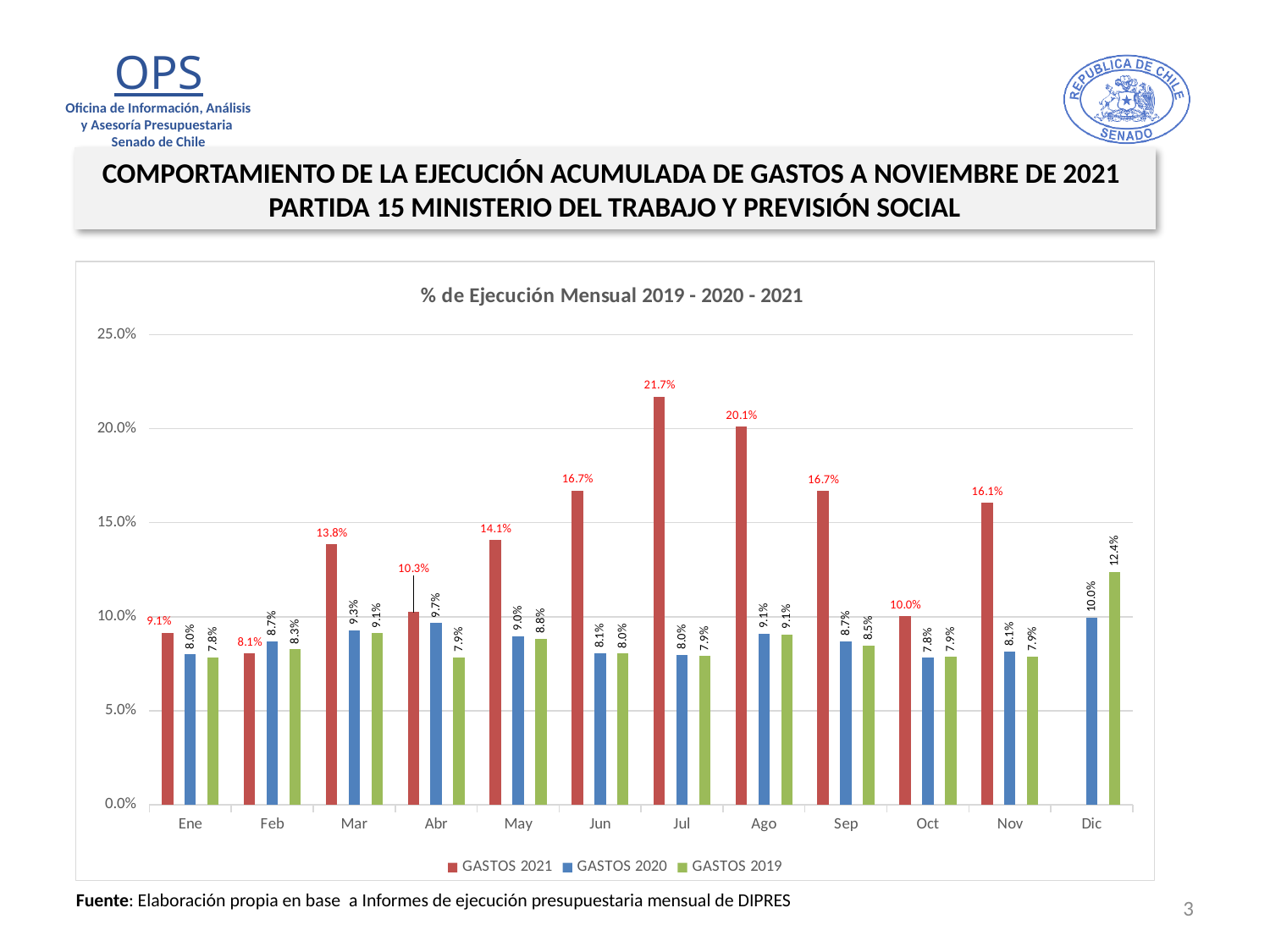
What is the value for GASTOS 2020 in Abr? 9.7% How many months are shown on the x axis? 12 What is the difference between GASTOS 2021 and GASTOS 2020 in Ago? 11.0% Which is larger in Feb: GASTOS 2021 or GASTOS 2020? GASTOS 2020 Is the value for GASTOS 2021 in Mar greater or less than 10.0%? greater What is the title of the chart? % de Ejecución Mensual 2019 - 2020 - 2021 In which month is the GASTOS 2020 value lowest? Oct In which month is the GASTOS 2021 value highest? Jul What is the value for GASTOS 2019 in Dic? 12.4% What is the value for GASTOS 2021 in Jul? 21.7% How many series does the legend list? 3 What type of chart is shown on the slide? bar chart